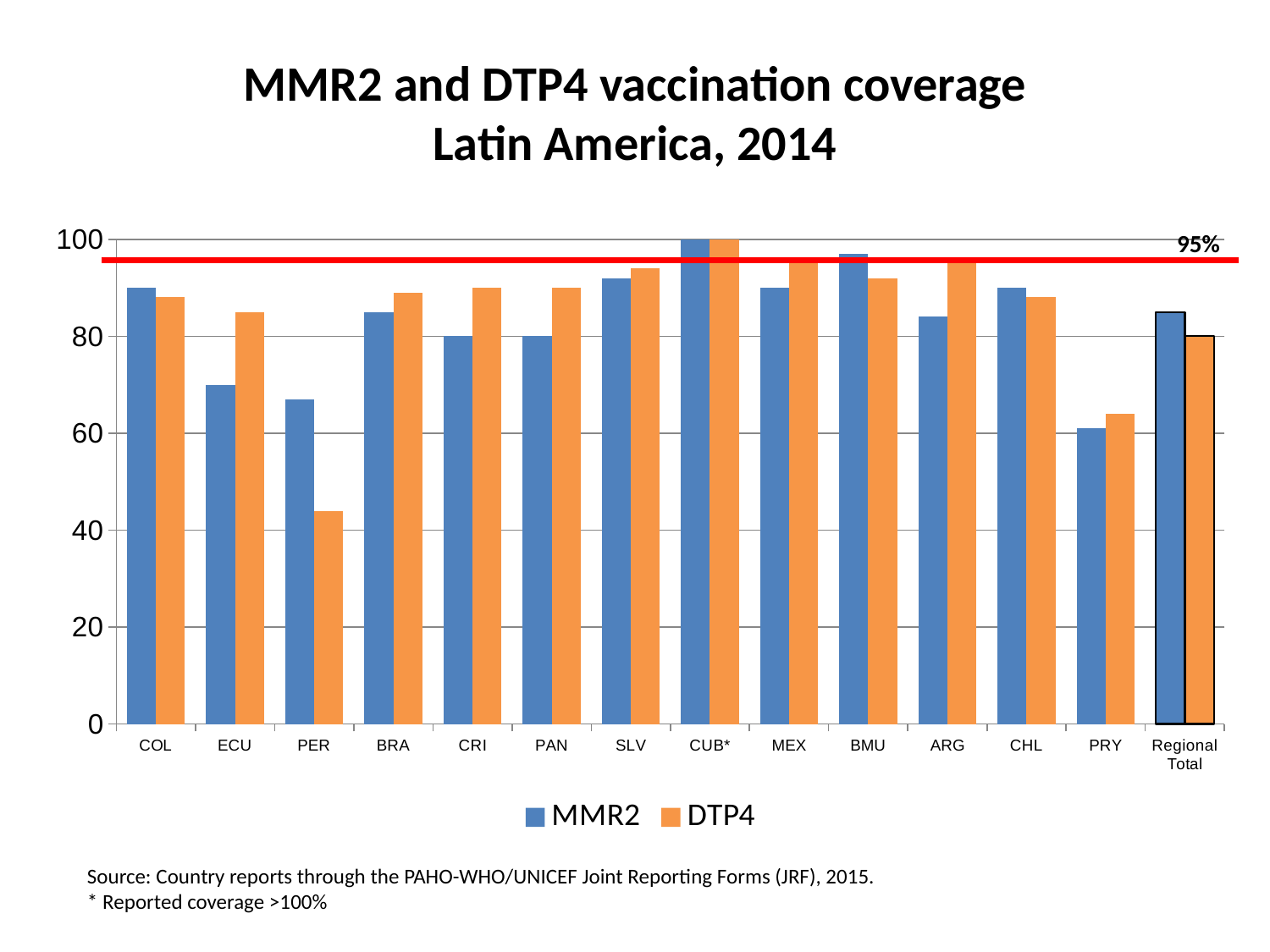
Is the DTP4 value for PER greater or less than 60? less What type of chart is shown on the slide? Bar chart Which category has the lowest DTP4 coverage? PER How many categories are shown along the x axis, including the Regional Total? 14 For PER, which is larger, the MMR2 value or the DTP4 value? MMR2 Which category has the highest MMR2 coverage? CUB* What coverage level does the red horizontal line mark? 95% What is the MMR2 coverage value for CRI? 80 What is the MMR2 coverage value for CUB*? 100 Which category has the lowest MMR2 coverage? PRY How many series does the legend list? 2 What is the DTP4 coverage value for the Regional Total? 80